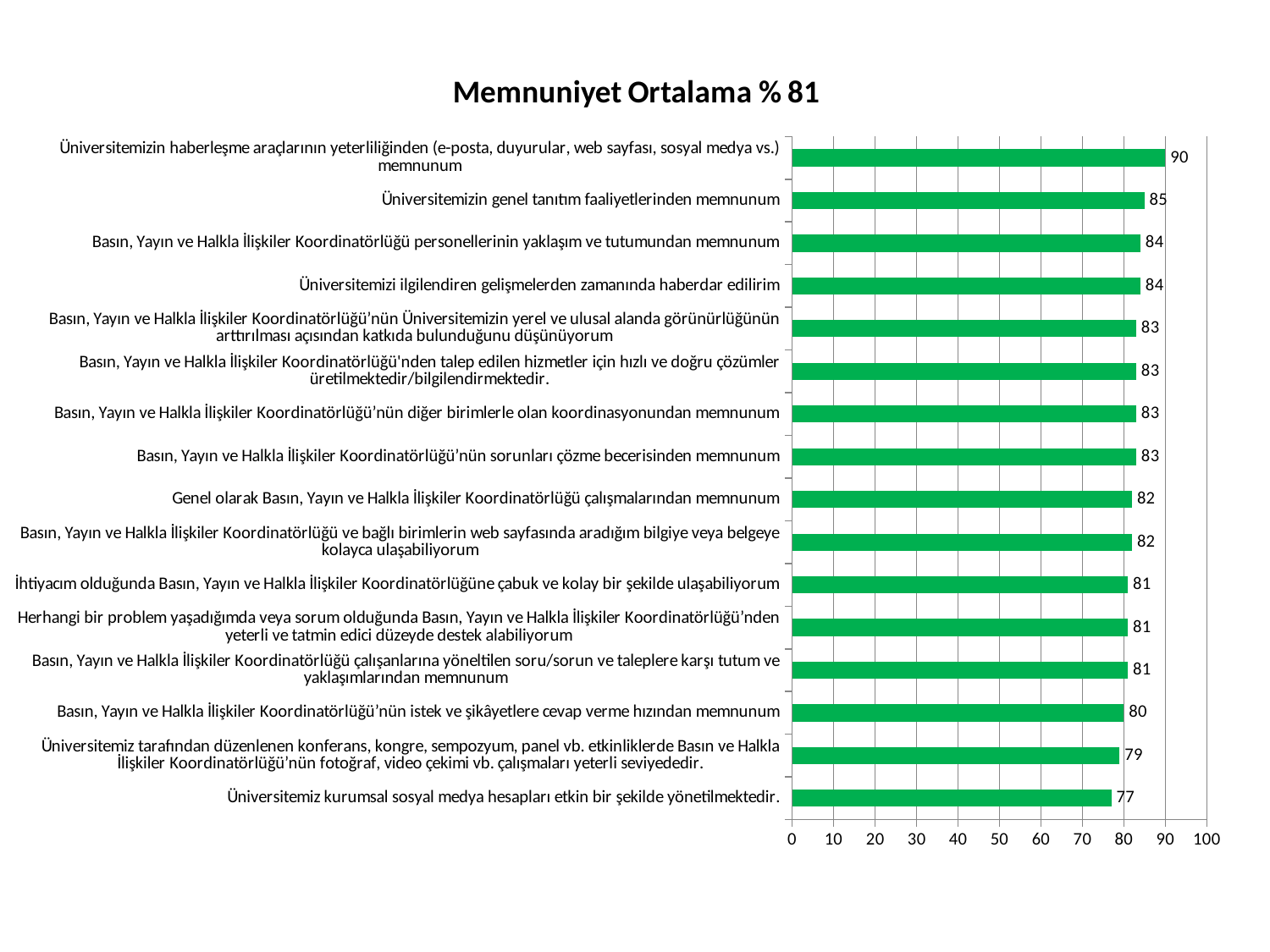
What is the difference between the highest value (90) and the lowest value (77)? 13 What is the title of the chart? Memnuniyet Ortalama % 81 What is the value for "Üniversitemiz kurumsal sosyal medya hesapları etkin bir şekilde yönetilmektedir."? 77 Which category has the lowest value? Üniversitemiz kurumsal sosyal medya hesapları etkin bir şekilde yönetilmektedir. What is the difference between the value for "Üniversitemizin genel tanıtım faaliyetlerinden memnunum" and the value for "Genel olarak Basın, Yayın ve Halkla İlişkiler Koordinatörlüğü çalışmalarından memnunum"? 3 How many categories are shown in the chart? 16 Which is larger: the value for "Üniversitemizi ilgilendiren gelişmelerden zamanında haberdar edilirim" or the value for "Üniversitemiz kurumsal sosyal medya hesapları etkin bir şekilde yönetilmektedir."? Üniversitemizi ilgilendiren gelişmelerden zamanında haberdar edilirim What is the value for "Basın, Yayın ve Halkla İlişkiler Koordinatörlüğü'nün istek ve şikâyetlere cevap verme hızından memnunum"? 80 What is the value for "Üniversitemizin genel tanıtım faaliyetlerinden memnunum"? 85 Which category has the highest value? Üniversitemizin haberleşme araçlarının yeterliliğinden (e-posta, duyurular, web sayfası, sosyal medya vs.) memnunum What kind of chart is shown on the slide? bar chart Is the value for "Üniversitemiz kurumsal sosyal medya hesapları etkin bir şekilde yönetilmektedir." greater or less than 80? less